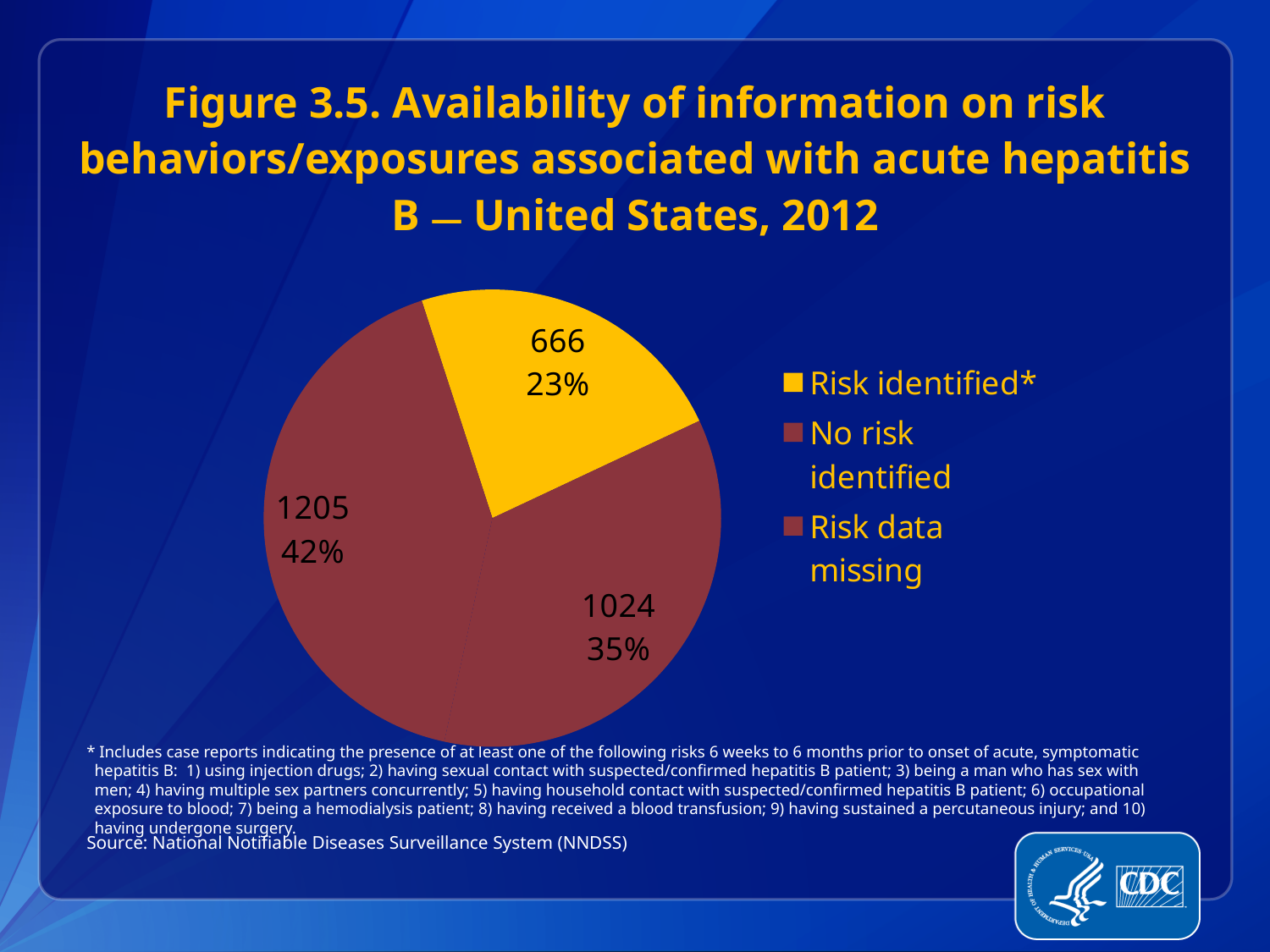
Is the slice labeled 1024 larger or smaller than the slice labeled 666? larger How many cases are in the 'Risk identified*' slice? 666 What percentage of the pie does the 'Risk identified*' slice represent? 23% What colour is the 'Risk identified*' slice? yellow What is the difference between the largest slice value (1205) and the 'Risk identified*' value (666)? 539 What is the total number of cases across all three slices? 2895 What is the value of the largest slice in the pie chart? 1205 Which legend category corresponds to the smallest slice of the pie? Risk identified* What type of chart is shown on the slide? pie chart What percentage is shown for the largest slice of the pie? 42% How many slices does the pie chart have? 3 How many entries does the legend list? 3